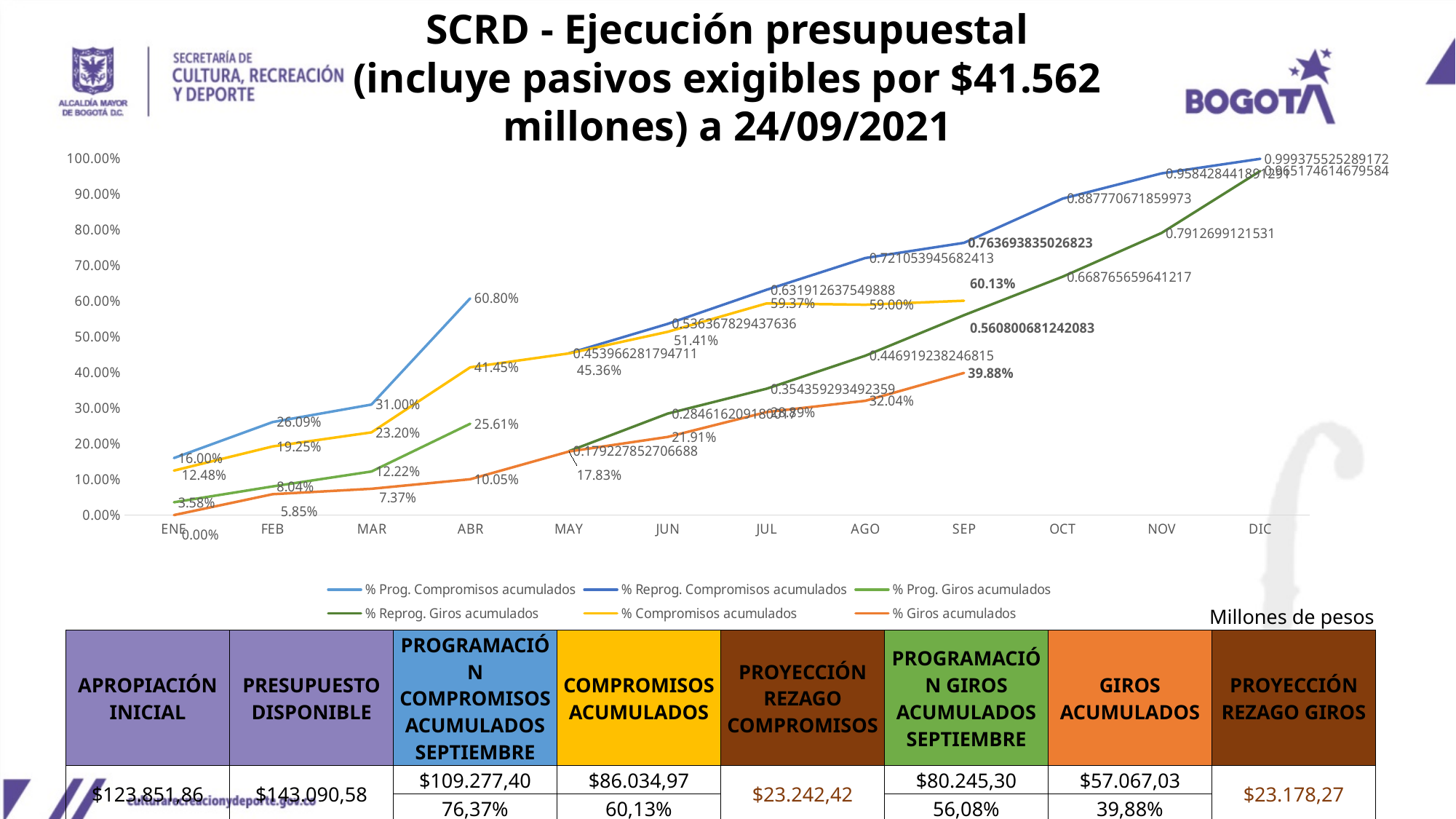
What is the value of % Prog. Giros acumulados in ABR? 25.61% What type of chart is shown on the slide? Line chart In which month does % Compromisos acumulados reach its highest value? SEP What is the difference between % Compromisos acumulados and % Giros acumulados in SEP? 20.25% In ABR, which is larger: % Prog. Compromisos acumulados or % Compromisos acumulados? % Prog. Compromisos acumulados Is the value of % Reprog. Compromisos acumulados in DIC greater or less than 90.00%? greater What is the value of % Giros acumulados in ENE? 0.00% What is the value of % Giros acumulados in SEP? 39.88% What is the value of % Prog. Compromisos acumulados in ABR? 60.80% What is the value of % Compromisos acumulados in SEP? 60.13% How many months are shown along the x axis of the chart? 12 How many series does the chart legend list? 6